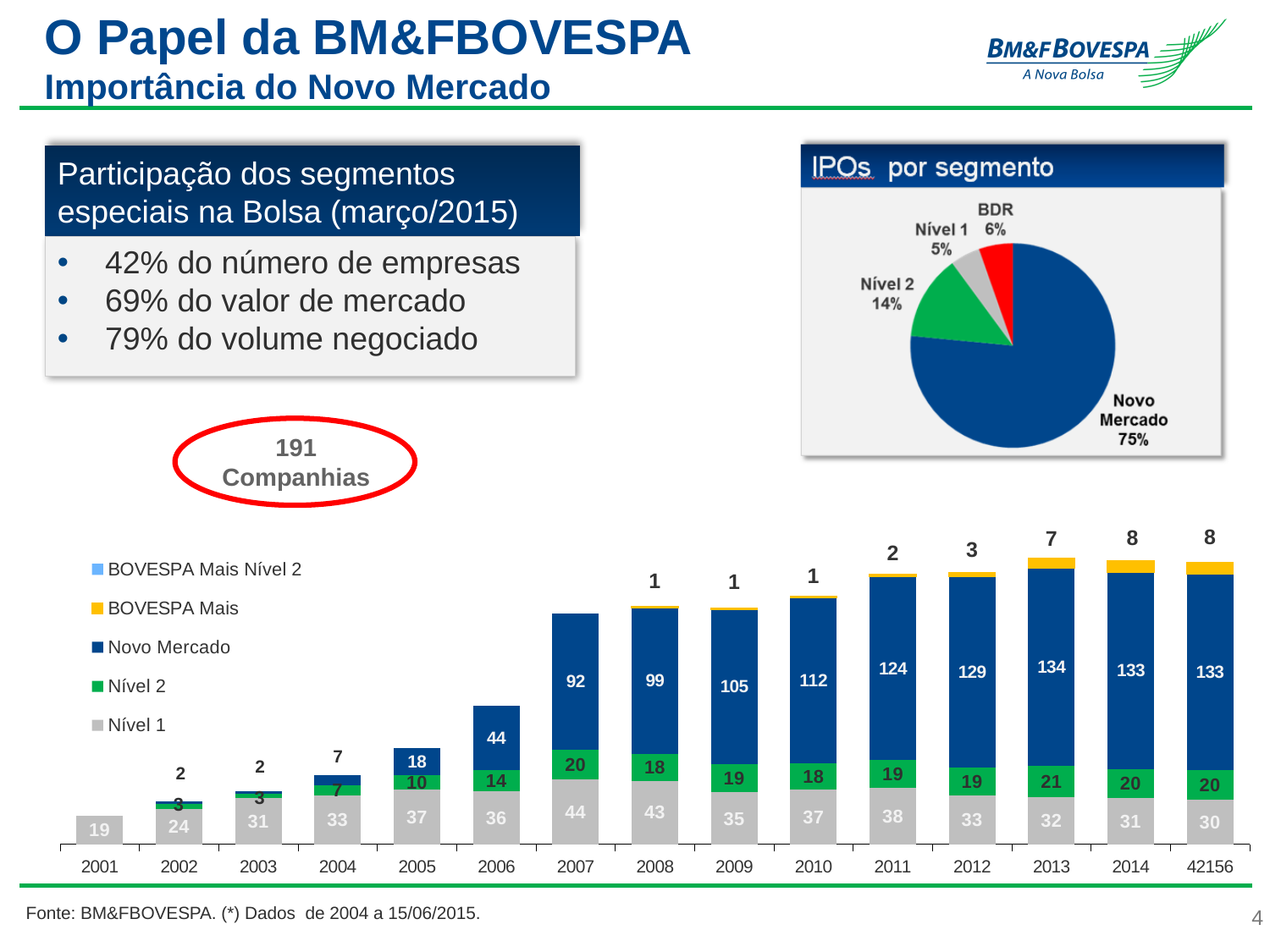
In the stacked bar chart at the bottom of the slide, does the Novo Mercado value rise or fall from 2007 to 2013? Rise In the stacked bar chart at the bottom of the slide, what is the difference between the Novo Mercado values for 2012 and 2011? 5 In the stacked bar chart at the bottom of the slide, what is the Novo Mercado value for 2013? 134 In the stacked bar chart at the bottom of the slide, what kind of chart is it? Stacked bar chart In the stacked bar chart at the bottom of the slide, which is larger: the Nível 2 value for 2013 or for 2014? 2013 In the stacked bar chart at the bottom of the slide, what is the total of the 2014 bar? 192 In the pie chart 'IPOs por segmento', how many slices are shown? 4 In the pie chart 'IPOs por segmento', what is the percentage for Nível 2? 14% In the pie chart 'IPOs por segmento', which segment has the smallest share? Nível 1 In the stacked bar chart at the bottom of the slide, what is the Nível 1 value for 2007? 44 In the stacked bar chart at the bottom of the slide, how many series does the legend list? 5 In the pie chart 'IPOs por segmento', what share does Novo Mercado have? 75%